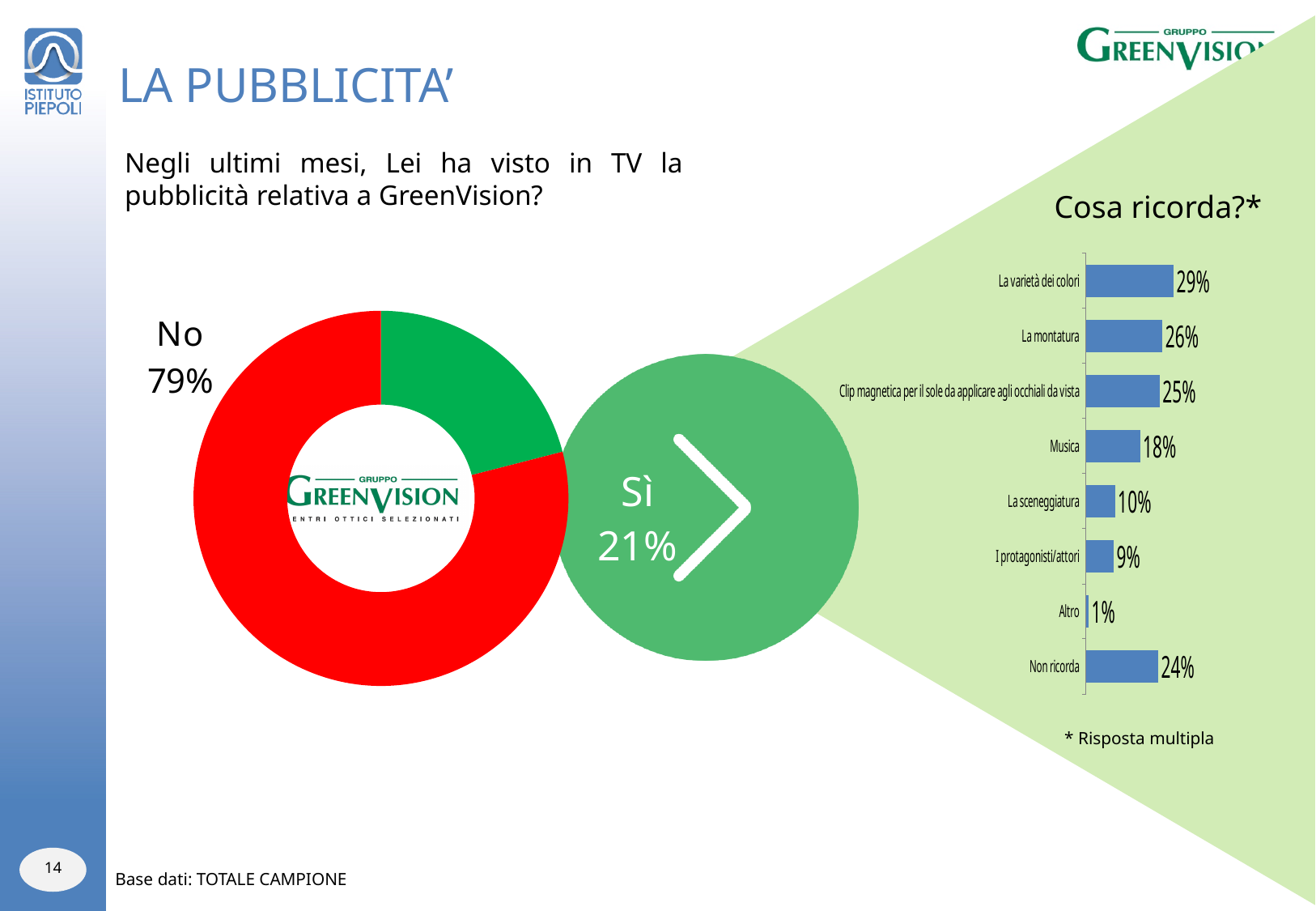
How many categories are shown in the "Cosa ricorda?" chart? 8 In the "Cosa ricorda?" chart, which category has the highest value? La varietà dei colori In the "Cosa ricorda?" chart, which category has the lowest value? Altro In the "Cosa ricorda?" chart, which is larger, "La sceneggiatura" or "I protagonisti/attori"? La sceneggiatura In the donut chart on the left, what share of respondents answered "Sì"? 21% In the "Cosa ricorda?" chart, what is the value for "La montatura"? 26% In the donut chart on the left, what is the difference between the "No" share and the "Sì" share? 58% In the donut chart on the left, what share of respondents answered "No"? 79% What kind of chart is the "Cosa ricorda?" chart? Bar chart In the "Cosa ricorda?" chart, what is the difference between "La varietà dei colori" and "Non ricorda"? 5% In the donut chart on the left, which answer has the larger share, "No" or "Sì"? No In the "Cosa ricorda?" chart, what is the value for "Musica"? 18%